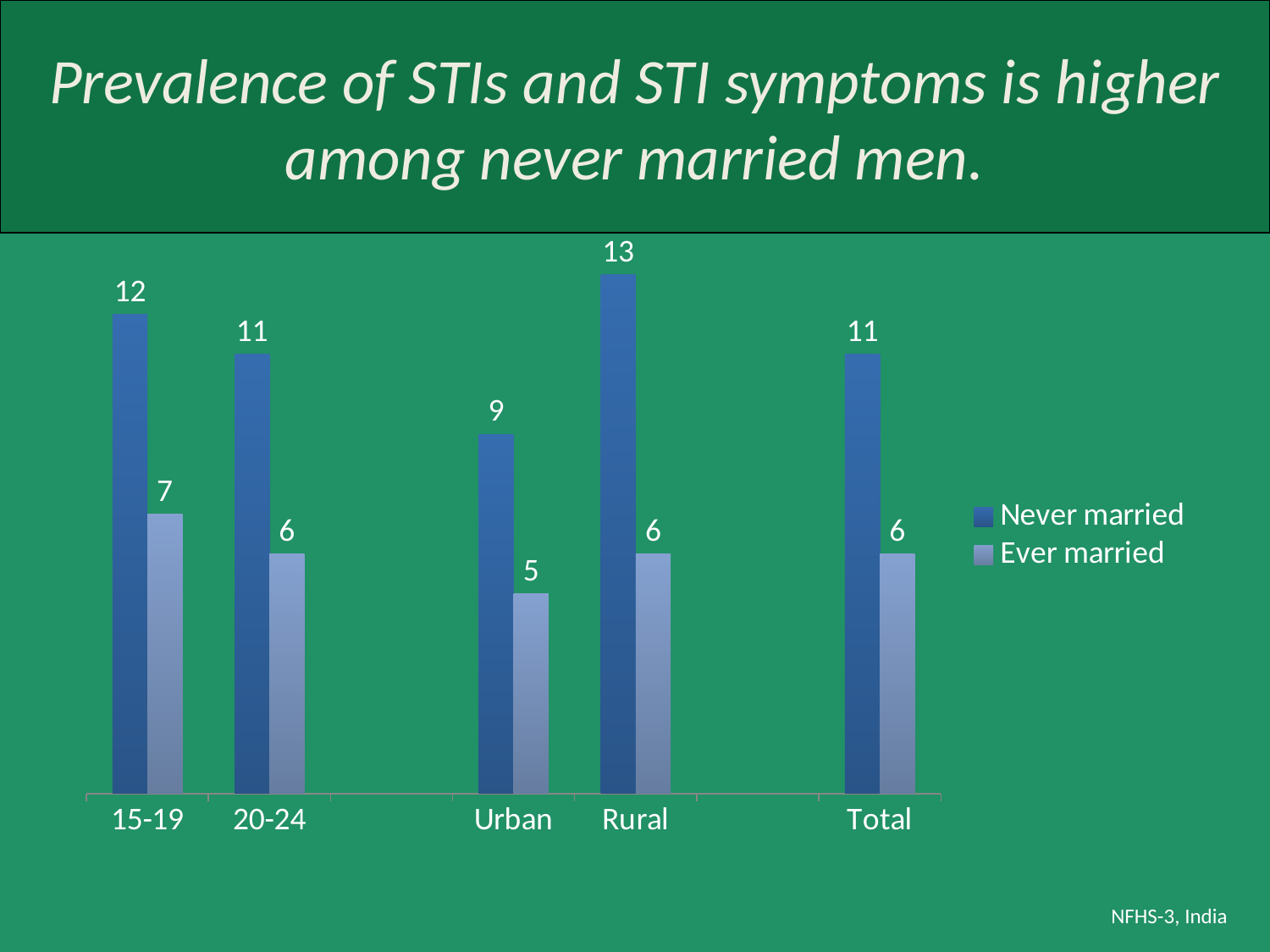
Which category has the highest Never married value? Rural What kind of chart is shown on the slide? Bar chart What is the value for Never married in the 15-19 category? 12 How many categories are shown on the x axis? 5 Which is larger: the Never married value for Urban or the Never married value for Rural? Rural Which category has the lowest Ever married value? Urban What is the value for Never married in the Rural category? 13 What is the value for Ever married in the Total category? 6 How many series does the legend list? 2 What is the value for Ever married in the Urban category? 5 What is the difference between the Never married values for 15-19 and 20-24? 1 What is the difference between the Never married and Ever married values in the Rural category? 7